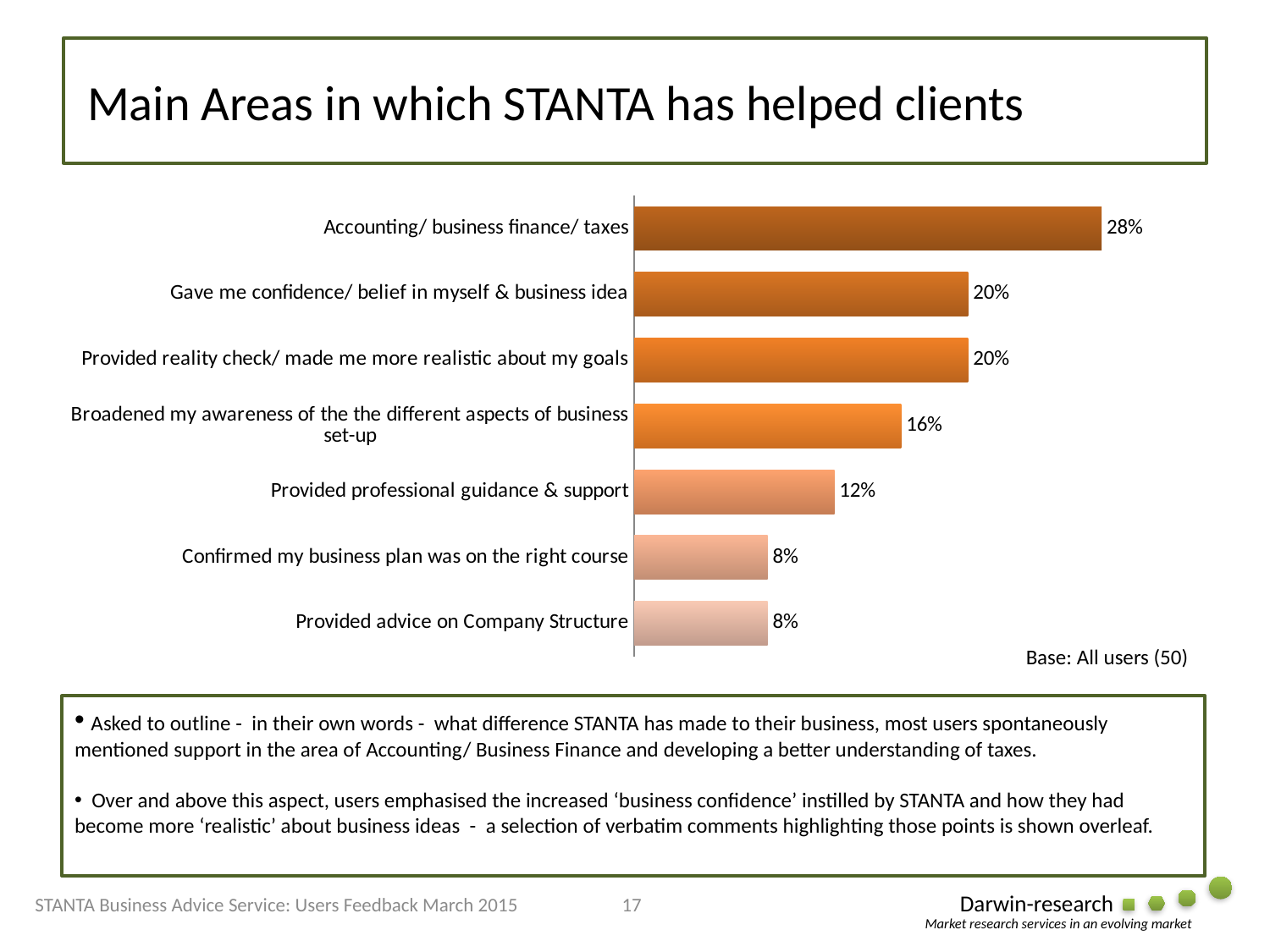
What is the title of the slide containing the chart? Main Areas in which STANTA has helped clients What is the value for 'Provided professional guidance & support'? 12% What base is stated for the chart? All users (50) Which category has the highest value in the chart? Accounting/ business finance/ taxes What is the difference between 'Provided professional guidance & support' and 'Confirmed my business plan was on the right course'? 4% What is the lowest value shown in the chart? 8% What percentage of users mentioned Accounting/ business finance/ taxes as an area in which STANTA helped? 28% What is the difference between the value for 'Accounting/ business finance/ taxes' and 'Gave me confidence/ belief in myself & business idea'? 8% How many categories are shown in the chart? 7 What kind of chart is shown on the slide? Bar chart Which is larger: the value for 'Provided reality check/ made me more realistic about my goals' or 'Provided professional guidance & support'? Provided reality check/ made me more realistic about my goals What is the value for 'Broadened my awareness of the the different aspects of business set-up'? 16%